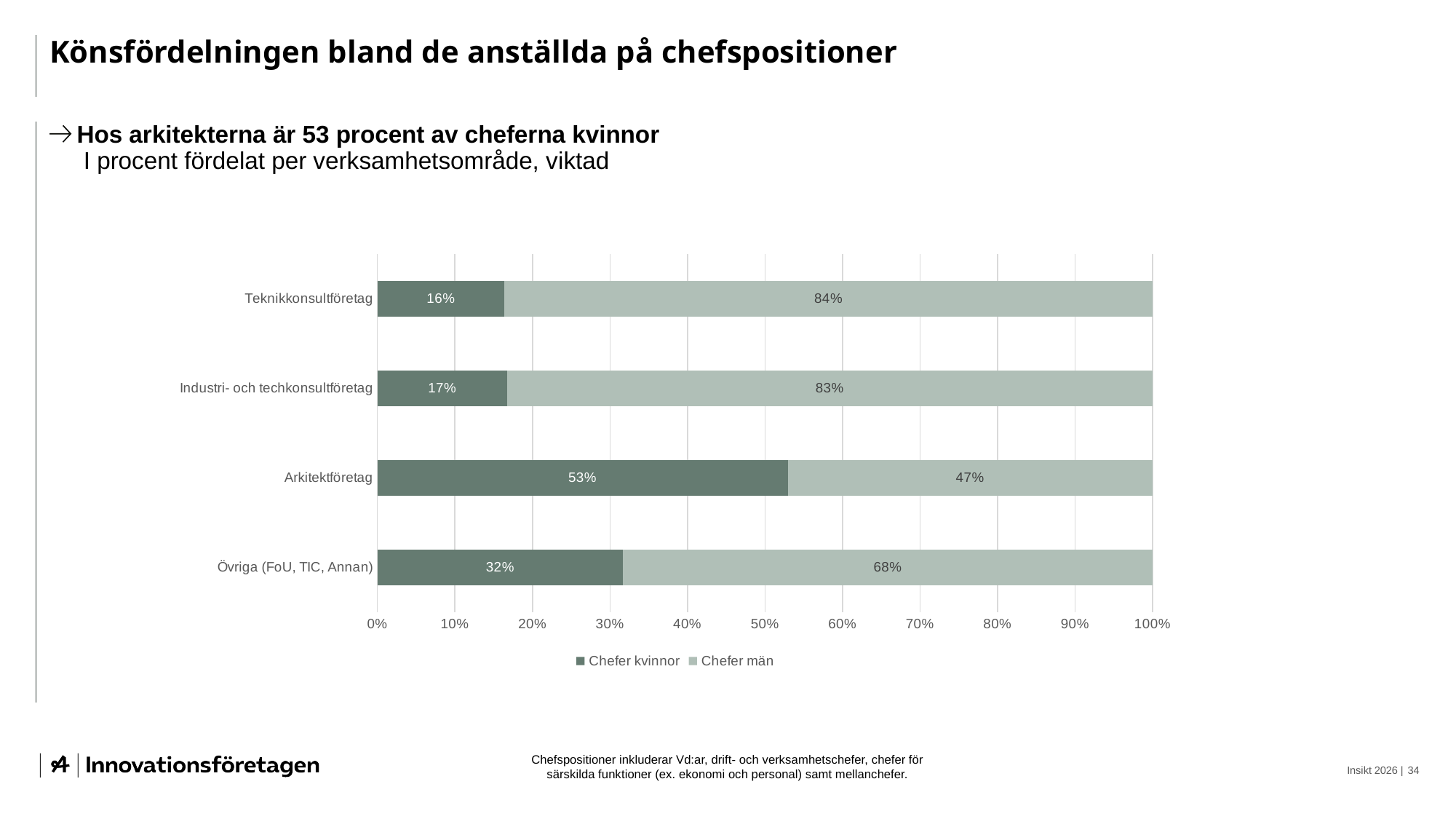
What kind of chart is shown on the slide? Stacked bar chart What is the value for Chefer män in Industri- och techkonsultföretag? 83% What is the value for Chefer kvinnor in Arkitektföretag? 53% What is the value for Chefer kvinnor in Övriga (FoU, TIC, Annan)? 32% How many categories are shown on the chart? 4 Which category has the highest value for Chefer kvinnor? Arkitektföretag Which category has the lowest value for Chefer kvinnor? Teknikkonsultföretag What is the value for Chefer män in Teknikkonsultföretag? 84% What is the difference between Chefer män and Chefer kvinnor in Övriga (FoU, TIC, Annan)? 36% What is the total of the stacked bar for Industri- och techkonsultföretag? 100% How many series does the legend list? 2 Which is larger in Arkitektföretag: Chefer kvinnor or Chefer män? Chefer kvinnor